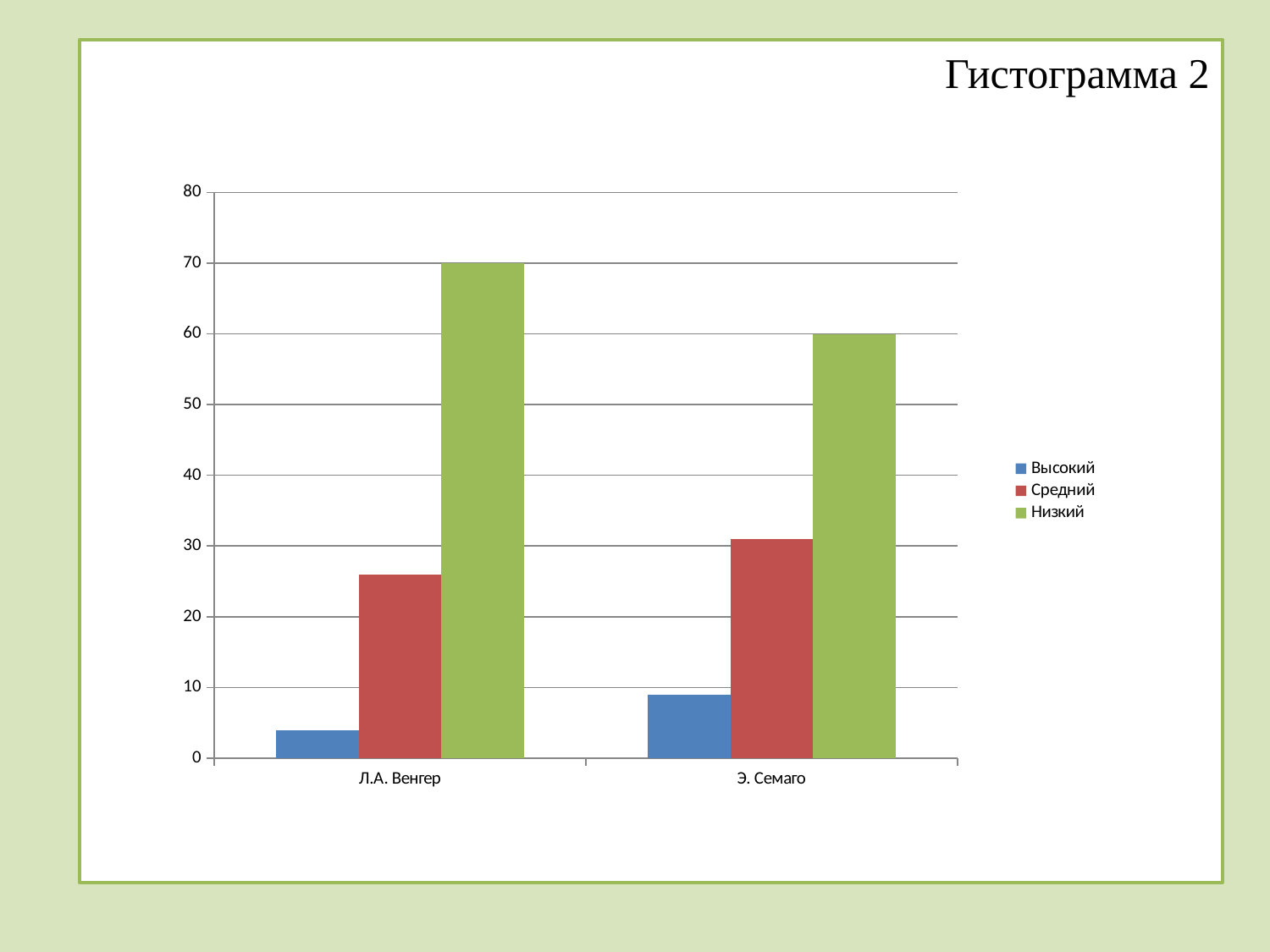
Which series has the highest value for Л.А. Венгер? Низкий What is the value of Низкий for Л.А. Венгер? 70 What is the difference between the Низкий values for Л.А. Венгер and Э. Семаго? 10 Is the value of Высокий for Л.А. Венгер greater or less than 10? less How many series does the legend list? 3 What type of chart is shown on the slide? bar chart Is the value of Средний for Л.А. Венгер greater or less than 20? greater Which is larger: the Средний value for Л.А. Венгер or for Э. Семаго? Э. Семаго What is the value of Низкий for Э. Семаго? 60 Which series has the lowest value for Э. Семаго? Высокий What is the title of the slide? Гистограмма 2 How many categories are shown on the x axis? 2